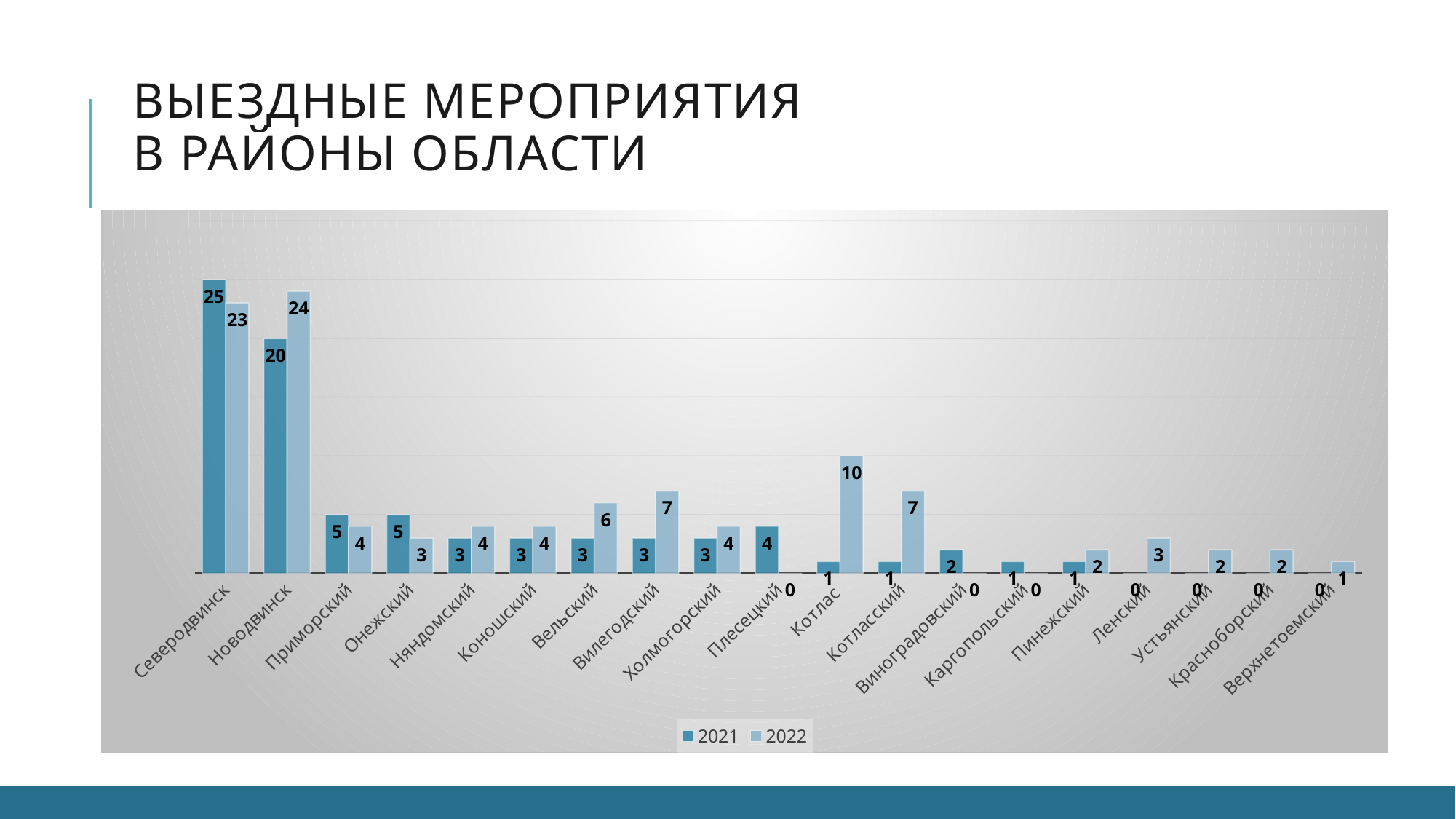
Which category has the highest 2022 value? Новодвинск How many series does the legend list? 2 How many categories are shown on the x axis? 19 What is the 2022 value for Котлас? 10 What is the 2022 value for Вилегодский? 7 Which is larger for Плесецкий, the 2021 value or the 2022 value? 2021 Which is larger for Вельский, the 2021 value or the 2022 value? 2022 What is the difference between the 2022 values for Котлас and Котласский? 3 Which category has the highest 2021 value? Северодвинск What is the difference between the 2021 and 2022 values for Новодвинск? 4 What is the 2021 value for Северодвинск? 25 What kind of chart is shown on the slide? Bar chart